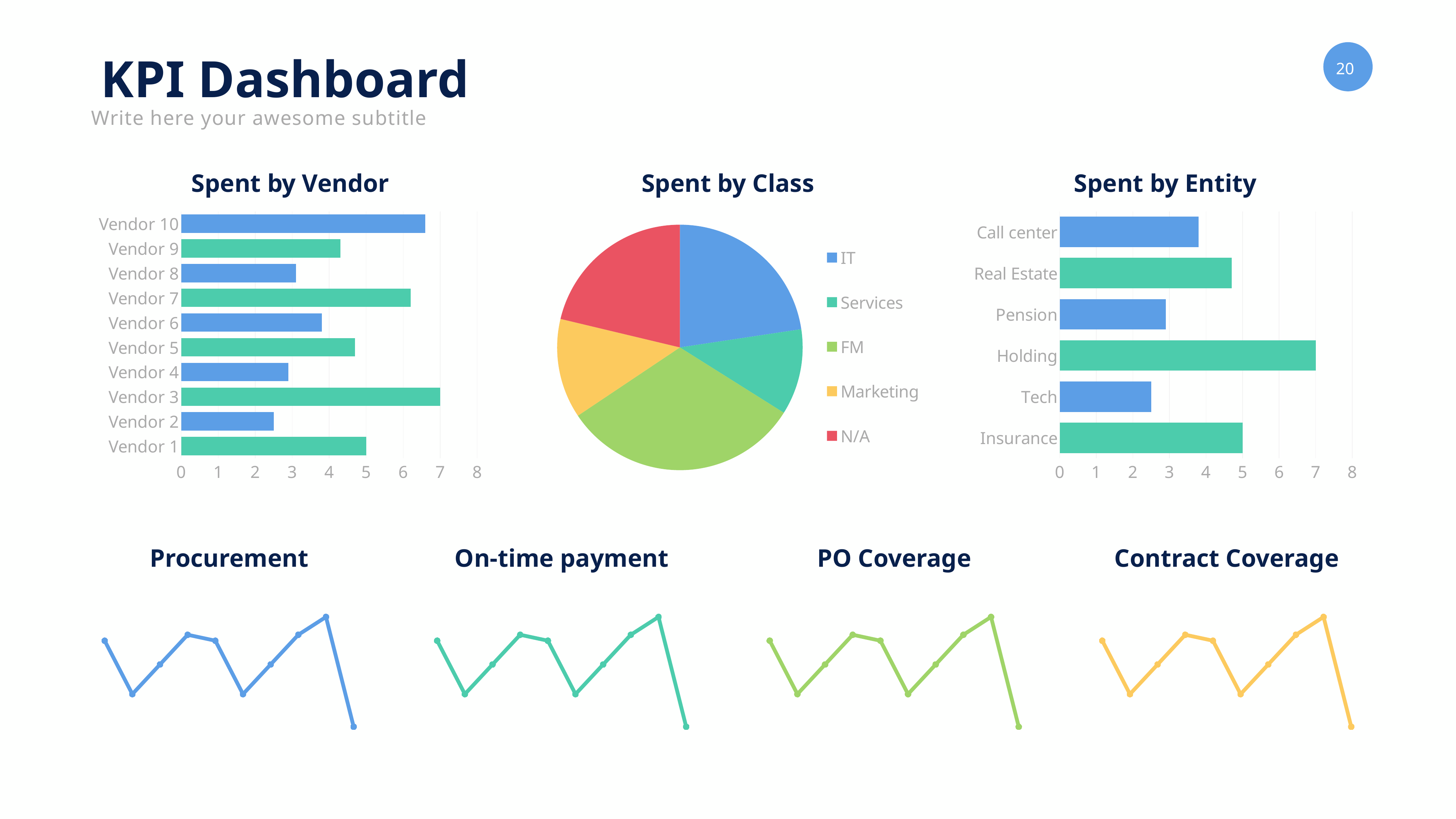
In the Spent by Class chart, which class has the largest slice? FM How many categories does the legend of the Spent by Class chart list? 5 What kind of chart is the Spent by Vendor chart? bar chart How many vendors are shown in the Spent by Vendor chart? 10 What kind of chart is the Spent by Class chart? pie chart In the Spent by Entity chart, which entity has the highest value? Holding In the Spent by Vendor chart, is the value for Vendor 10 greater or less than 6? greater In the Spent by Entity chart, which is larger, Insurance or Call center? Insurance In the Spent by Vendor chart, which is larger, Vendor 7 or Vendor 9? Vendor 7 In the Spent by Vendor chart, which vendor has the highest value? Vendor 3 In the Spent by Entity chart, is the value for Tech greater or less than 3? less What kind of chart is the Procurement chart at the bottom left of the slide? line chart